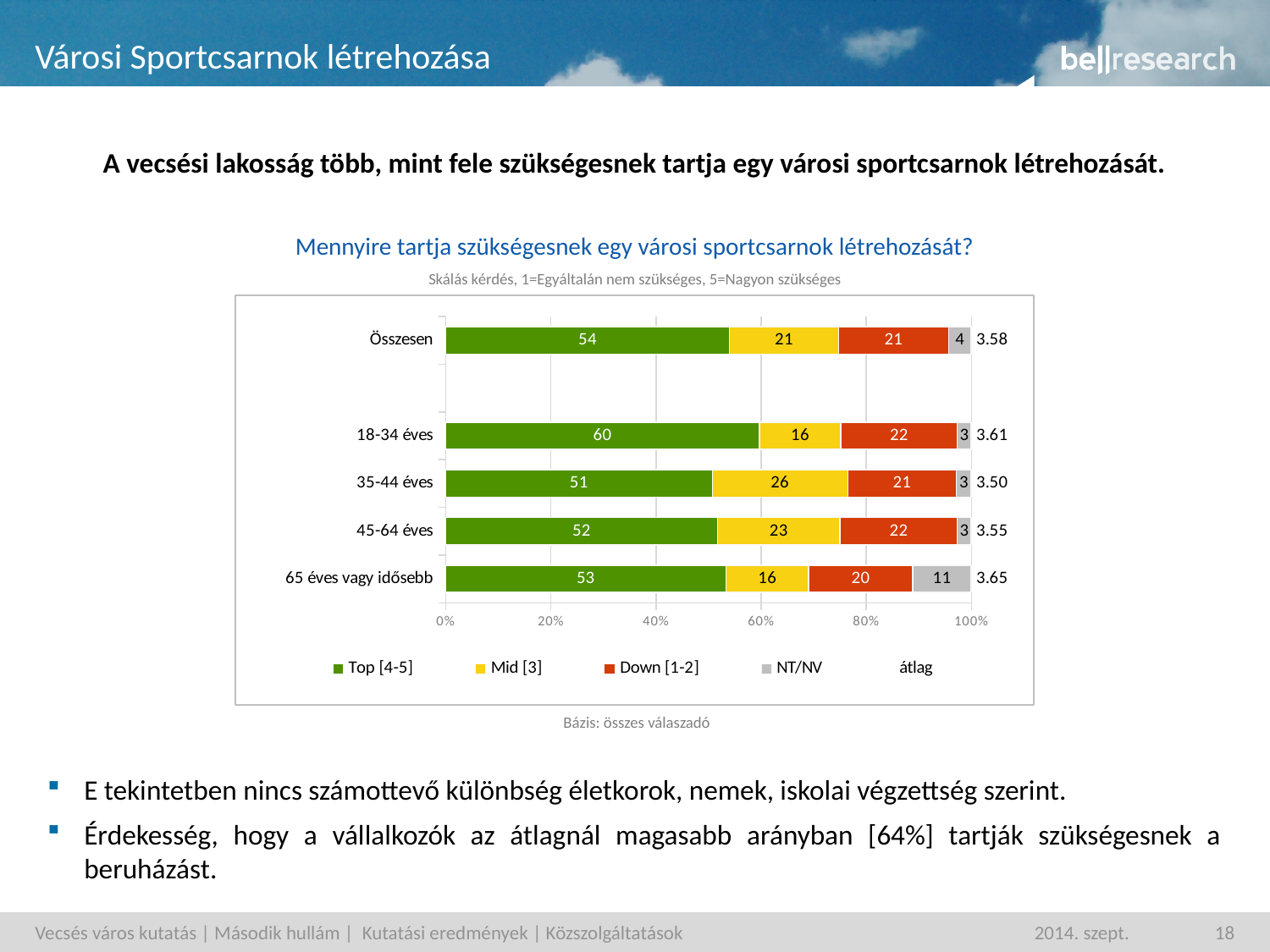
Which category has the lowest átlag (average) value? 35-44 éves What is the difference between the Top [4-5] values for 18-34 éves and 35-44 éves? 9 How many entries does the chart legend list? 5 Which category has the highest Top [4-5] value? 18-34 éves What is the Top [4-5] value for the 18-34 éves category? 60 What is the átlag (average) shown for the Összesen row? 3.58 What is the Mid [3] value for the 35-44 éves category? 26 How many categories are shown on the y axis of the chart? 5 What is the NT/NV value for the 65 éves vagy idősebb category? 11 What is the title of the chart? Mennyire tartja szükségesnek egy városi sportcsarnok létrehozását? Is the Down [1-2] value larger for 18-34 éves or for 65 éves vagy idősebb? 18-34 éves What kind of chart is shown on the slide? Stacked bar chart